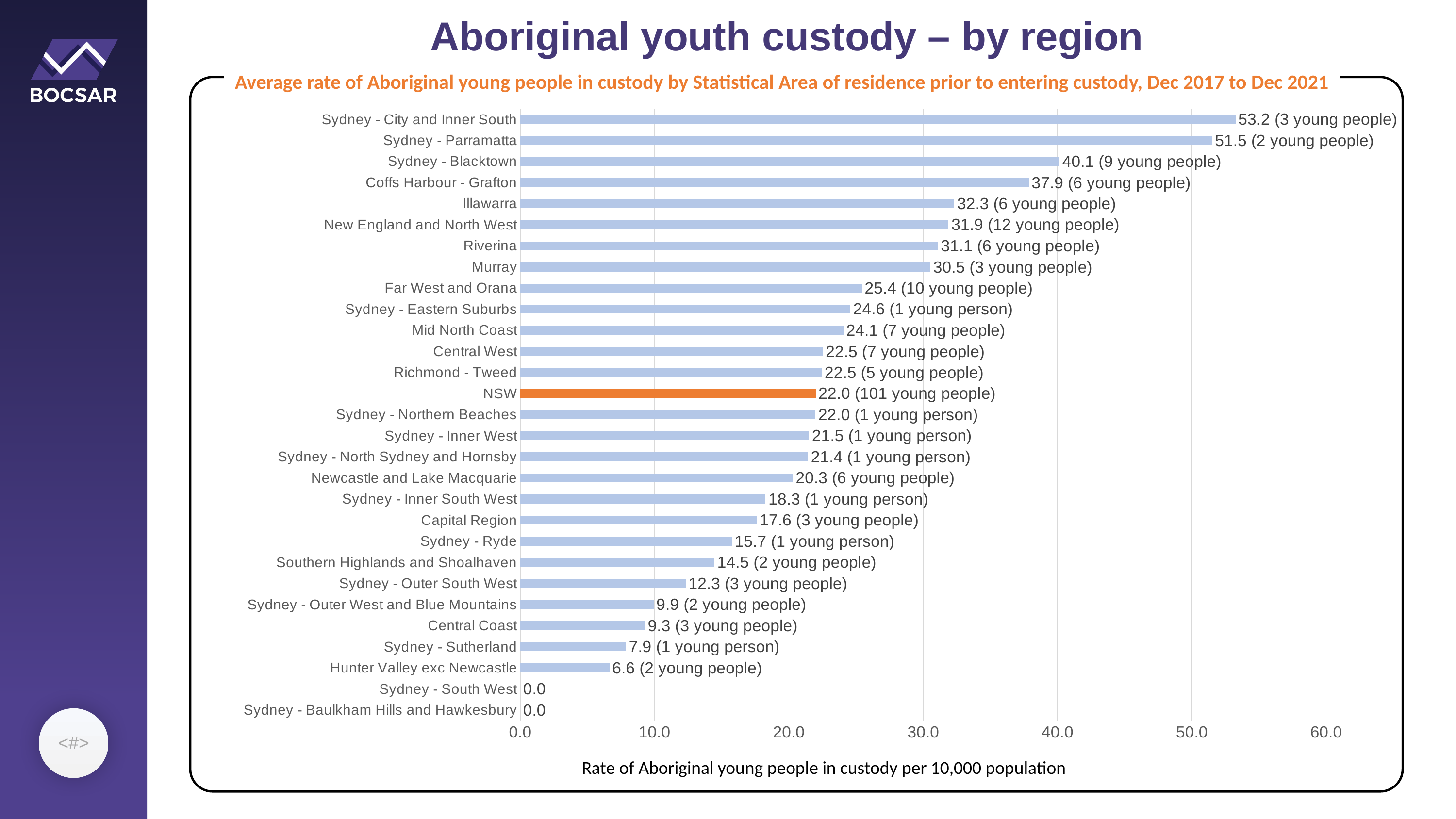
Which region has the highest rate? Sydney - City and Inner South What is the rate for Sydney - Blacktown? 40.1 What is the rate for Hunter Valley exc Newcastle? 6.6 What is the difference between the rates for Coffs Harbour - Grafton and Illawarra? 5.6 What is the difference between the rates for Sydney - City and Inner South and Sydney - Parramatta? 1.7 What type of chart is shown? bar chart How many young people are shown in the data label for NSW? 101 young people Is the rate for Capital Region greater or less than 20.0? less Which has a higher rate, Murray or Far West and Orana? Murray How many regions (bars) are listed on the chart? 29 What is the rate for New England and North West? 31.9 Which bar is coloured orange rather than blue? NSW